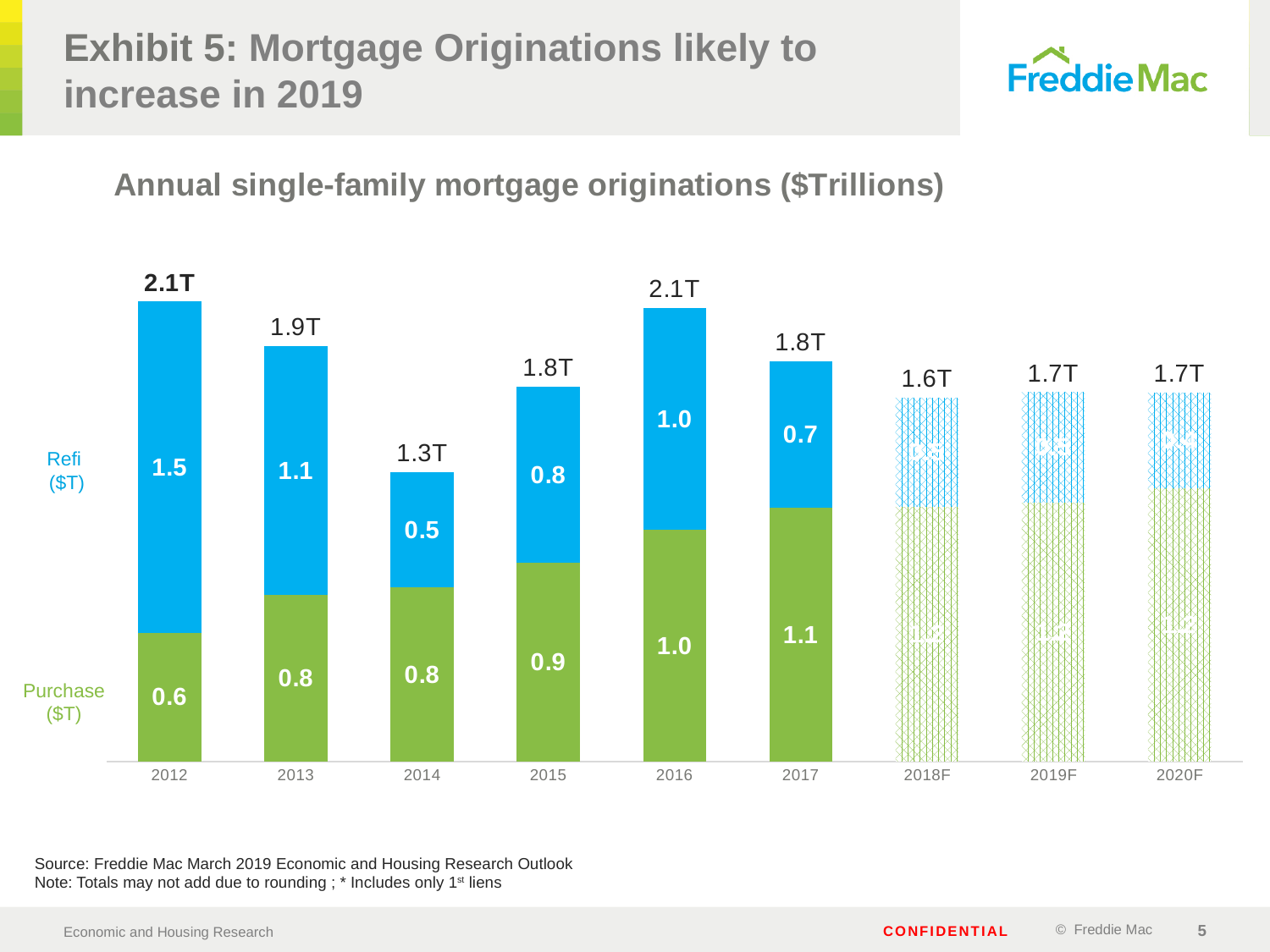
What is the Refi value for 2012? 1.5 Which series is shown in green? Purchase ($T) What is the total annual single-family mortgage originations for 2019F? 1.7T What is the total annual single-family mortgage originations for 2014? 1.3T Which year has the highest Refi value? 2012 What kind of chart is shown on the slide? Stacked bar chart Is the Purchase value larger in 2016 or in 2012? 2016 How many years are shown on the x axis? 9 What is the difference between the Refi value in 2012 and the Refi value in 2017? 0.8 Which year has the lowest total mortgage originations? 2014 What is the Purchase value for 2017? 1.1 How many series does the chart show? 2